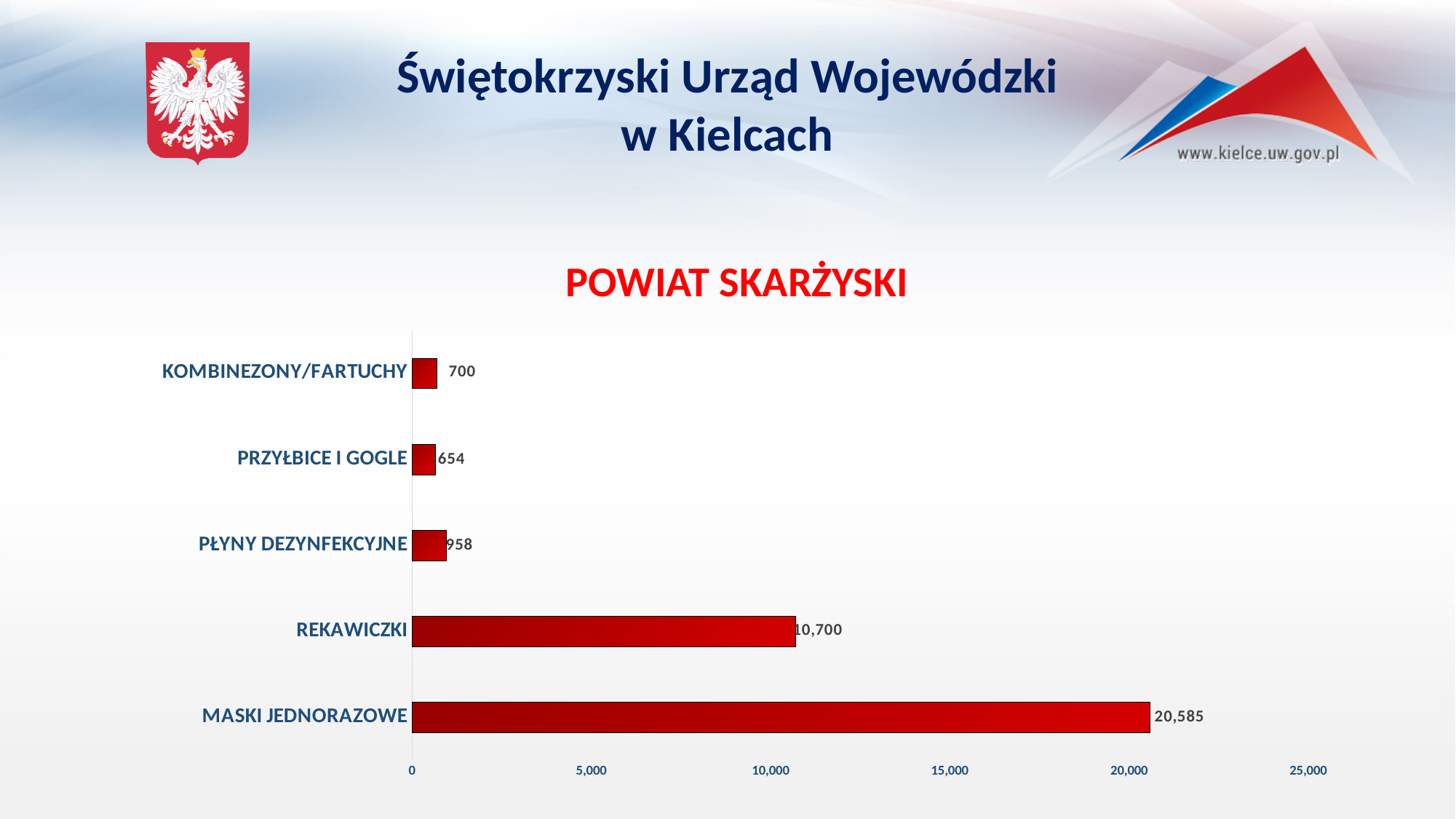
Which category has the lowest value? PRZYŁBICE I GOGLE What is the value for KOMBINEZONY/FARTUCHY? 700 What is the value for PŁYNY DEZYNFEKCYJNE? 958 What kind of chart is shown on the slide? bar chart Which is larger, the value for PŁYNY DEZYNFEKCYJNE or the value for KOMBINEZONY/FARTUCHY? PŁYNY DEZYNFEKCYJNE Is the value for MASKI JEDNORAZOWE greater or less than 20,000? greater Which category has the highest value? MASKI JEDNORAZOWE How many categories are shown in the chart? 5 What is the value for PRZYŁBICE I GOGLE? 654 What is the difference between the values for MASKI JEDNORAZOWE and RĘKAWICZKI? 9,885 What is the value for RĘKAWICZKI? 10,700 What is the value for MASKI JEDNORAZOWE? 20,585